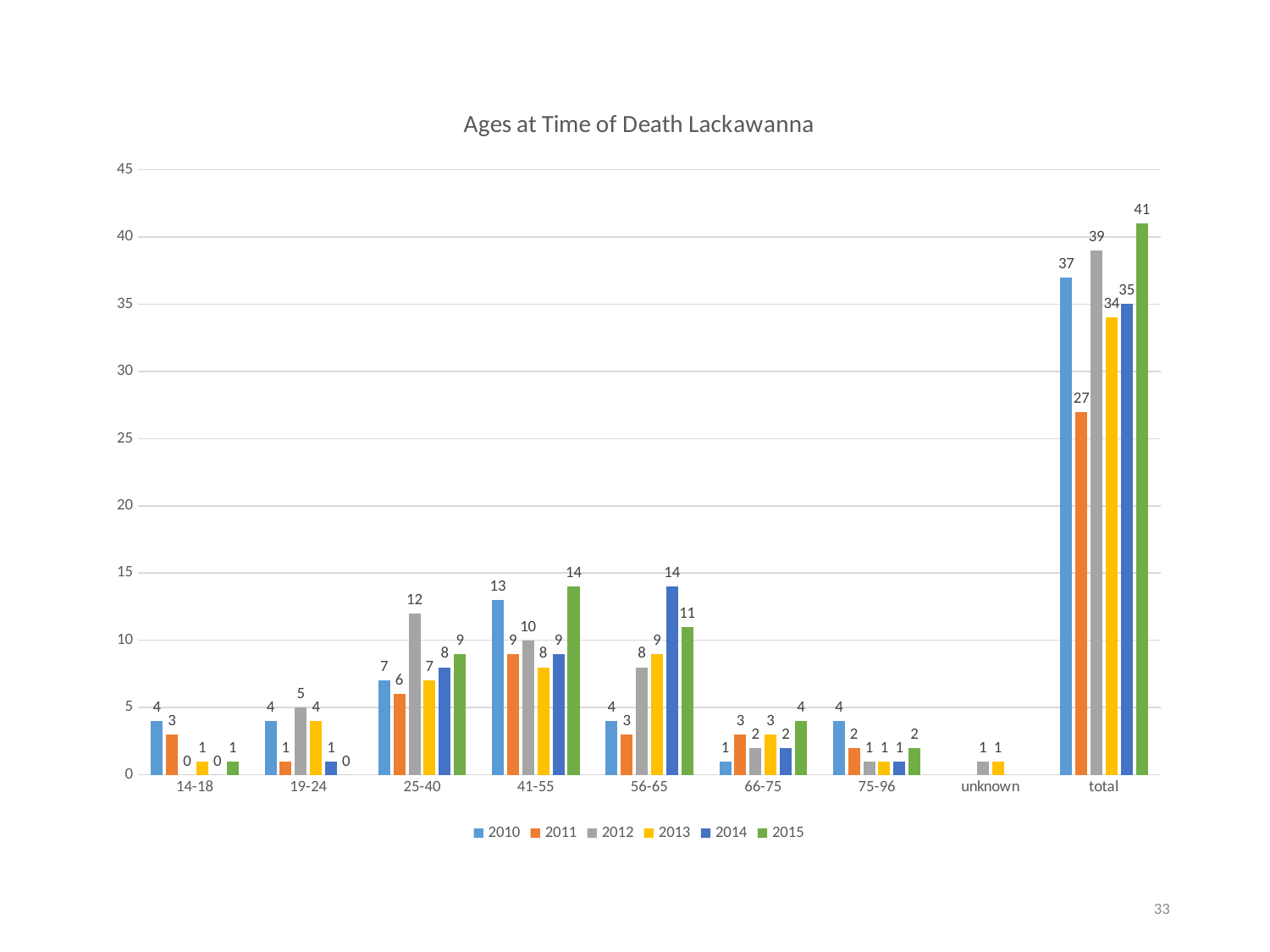
What is the value for 2015 in the total category? 41 What is the title of the chart? Ages at Time of Death Lackawanna What kind of chart is shown on the slide? Bar chart Which year has the lowest total? 2011 What is the value for 2014 in the 56-65 age group? 14 How many series does the legend list? 6 What is the value for 2011 in the 19-24 age group? 1 How many age categories are shown on the x axis? 9 Which year has the highest total? 2015 What is the difference between the 2015 total and the 2011 total? 14 What is the value for 2012 in the 25-40 age group? 12 In the 41-55 age group, which is larger: the value for 2010 or the value for 2013? 2010